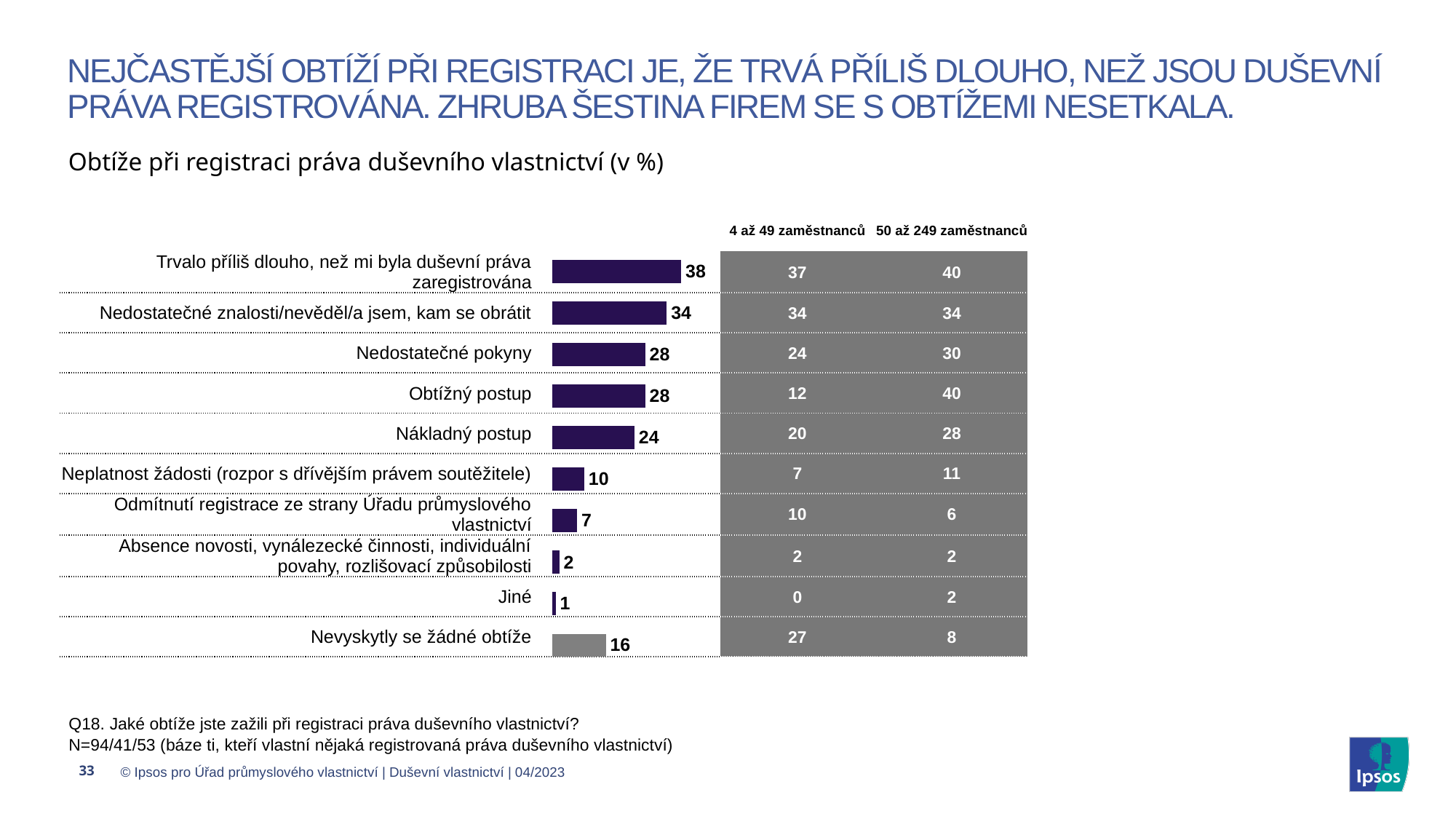
What is the difference between the "4 až 49 zaměstnanců" and "50 až 249 zaměstnanců" values for "Obtížný postup" in the table? 28 Which category has the lowest value in the bar chart? Jiné Which category has the highest value in the bar chart? Trvalo příliš dlouho, než mi byla duševní práva zaregistrována Which is larger: the value for "Nákladný postup" or the value for "Neplatnost žádosti (rozpor s dřívějším právem soutěžitele)"? Nákladný postup In the table to the right of the chart, what is the value for "Obtížný postup" in the "50 až 249 zaměstnanců" column? 40 In the table to the right of the chart, what is the value for "Nevyskytly se žádné obtíže" in the "4 až 49 zaměstnanců" column? 27 What is the value for "Nedostatečné pokyny" in the bar chart? 28 How many categories are shown in the bar chart? 10 What kind of chart is shown on the slide? bar chart What is the value for "Nevyskytly se žádné obtíže" in the bar chart? 16 What is the subtitle of the chart shown on the slide? Obtíže při registraci práva duševního vlastnictví (v %) What is the difference between the values for "Trvalo příliš dlouho, než mi byla duševní práva zaregistrována" and "Nedostatečné znalosti/nevěděl/a jsem, kam se obrátit"? 4